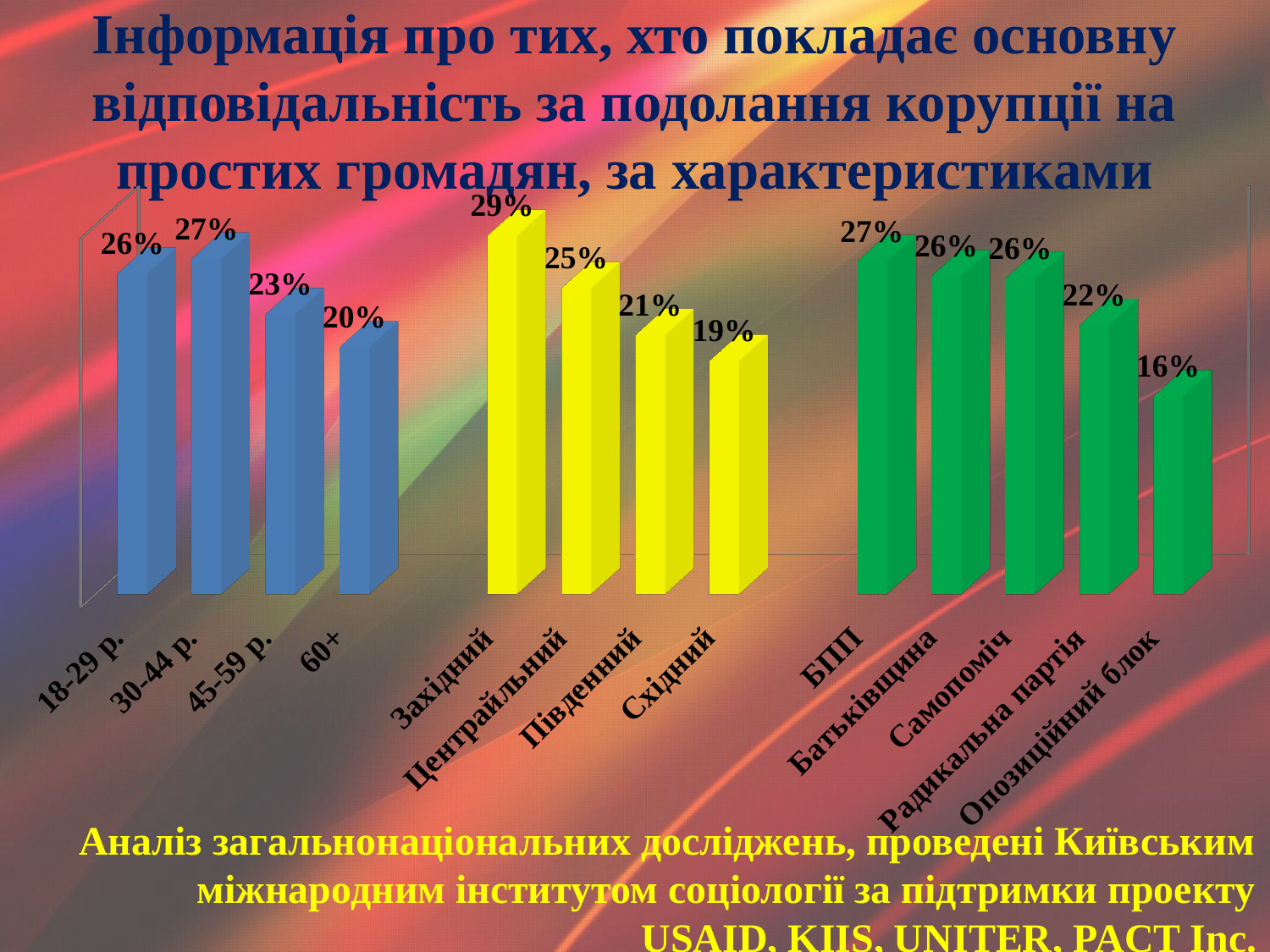
In the middle (yellow) chart, do the values rise or fall from Західний to Східний? fall In the middle (yellow) chart, what is the value for Західний? 29% In the middle (yellow) chart, how many categories are shown? 4 In the middle (yellow) chart, which region has the highest value? Західний In the right (green) chart, what is the value for Радикальна партія? 22% What kind of chart is the left (blue) chart? bar chart In the right (green) chart, which party has the lowest value? Опозиційний блок In the left (blue) chart, what is the value for 30-44 р.? 27% In the right (green) chart, how many categories are shown? 5 In the right (green) chart, which is larger, the value for БПП or the value for Опозиційний блок? БПП In the left (blue) chart, which age group has the lowest value? 60+ In the left (blue) chart, what is the difference between the values for 18-29 р. and 60+? 6%